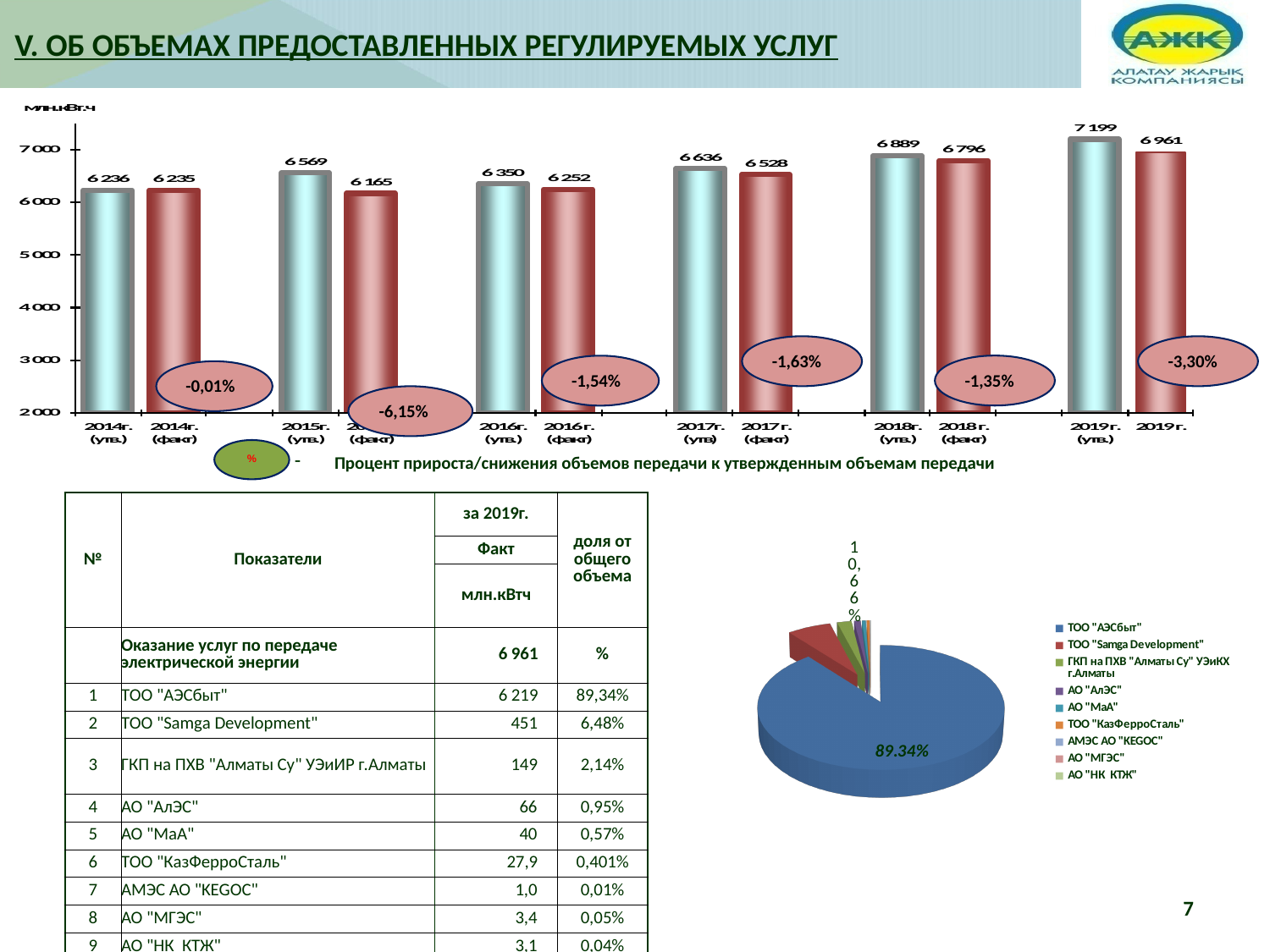
How many entries does the pie chart legend list? 9 In the bar chart, how many bars are plotted? 12 In the bar chart, what is the value for 2019 г. (утв.)? 7 199 In the pie chart, what share is labelled for the largest slice? 89.34% In the bar chart, which bar has the highest value? 2019 г. (утв.) In the bar chart, what is the value for 2017 г. (факт)? 6 528 What type of chart is shown at the top of the slide? bar chart In the bar chart, what is the difference between 2019 г. (утв.) and 2019 г. (факт)? 238 In the bar chart, what is the difference between 2018 г. (утв.) and 2018 г. (факт)? 93 In the bar chart, which bar has the lowest value? 2015 г. (факт) In the bar chart, what is the value for 2015 г. (факт)? 6 165 In the bar chart, which is larger: 2016 г. (утв.) or 2016 г. (факт)? 2016 г. (утв.)